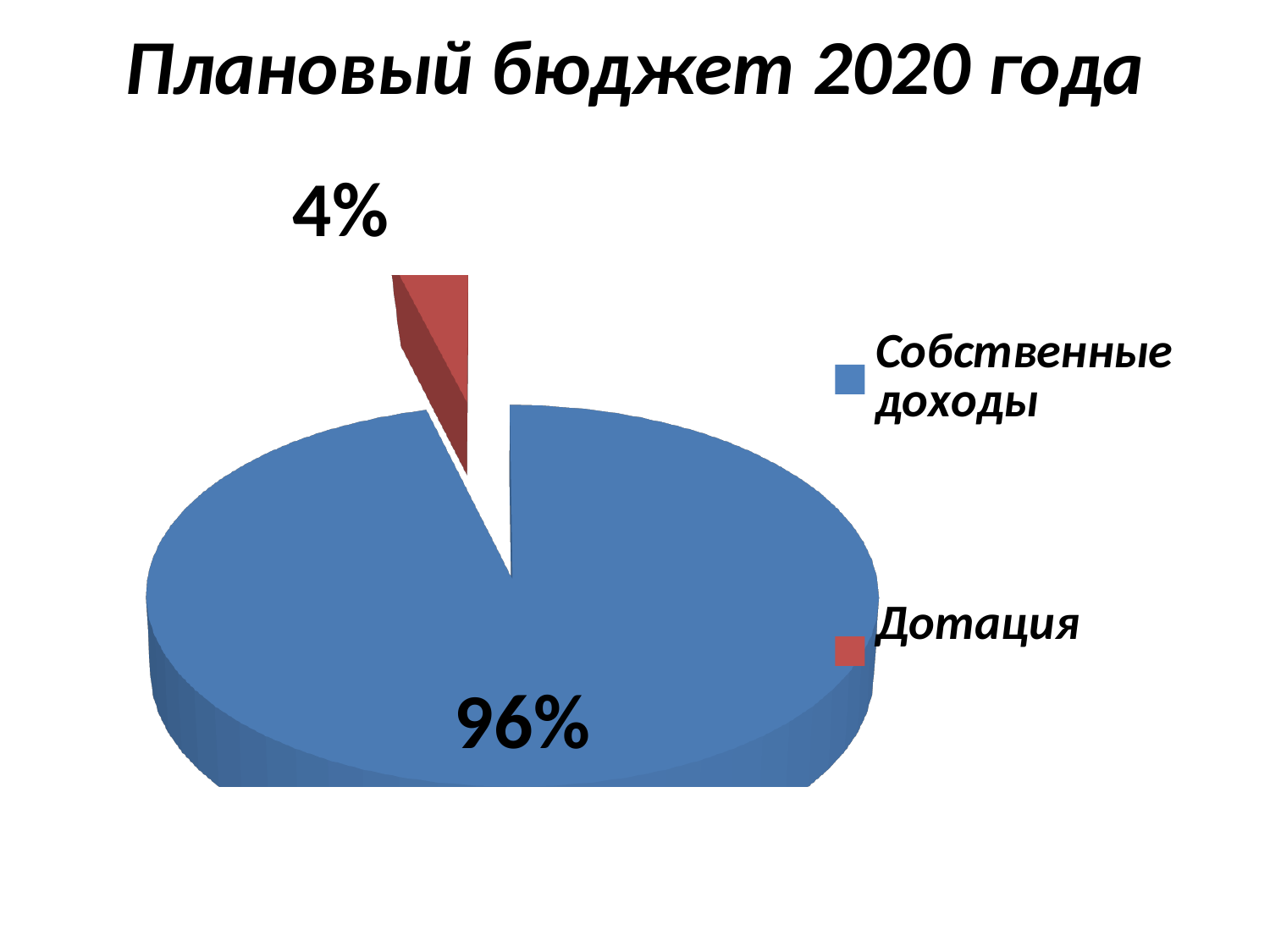
Which category has the smallest slice of the pie? Дотация Which category has the largest slice of the pie? Собственные доходы How many categories are shown in the pie chart? 2 What kind of chart is shown on the slide? Pie chart Which is larger, Собственные доходы or Дотация? Собственные доходы What share of the pie does Собственные доходы represent? 96% What is the title of the slide? Плановый бюджет 2020 года What is the difference in percentage points between Собственные доходы and Дотация? 92 What colour is the Дотация slice? Red What share of the pie does Дотация represent? 4%